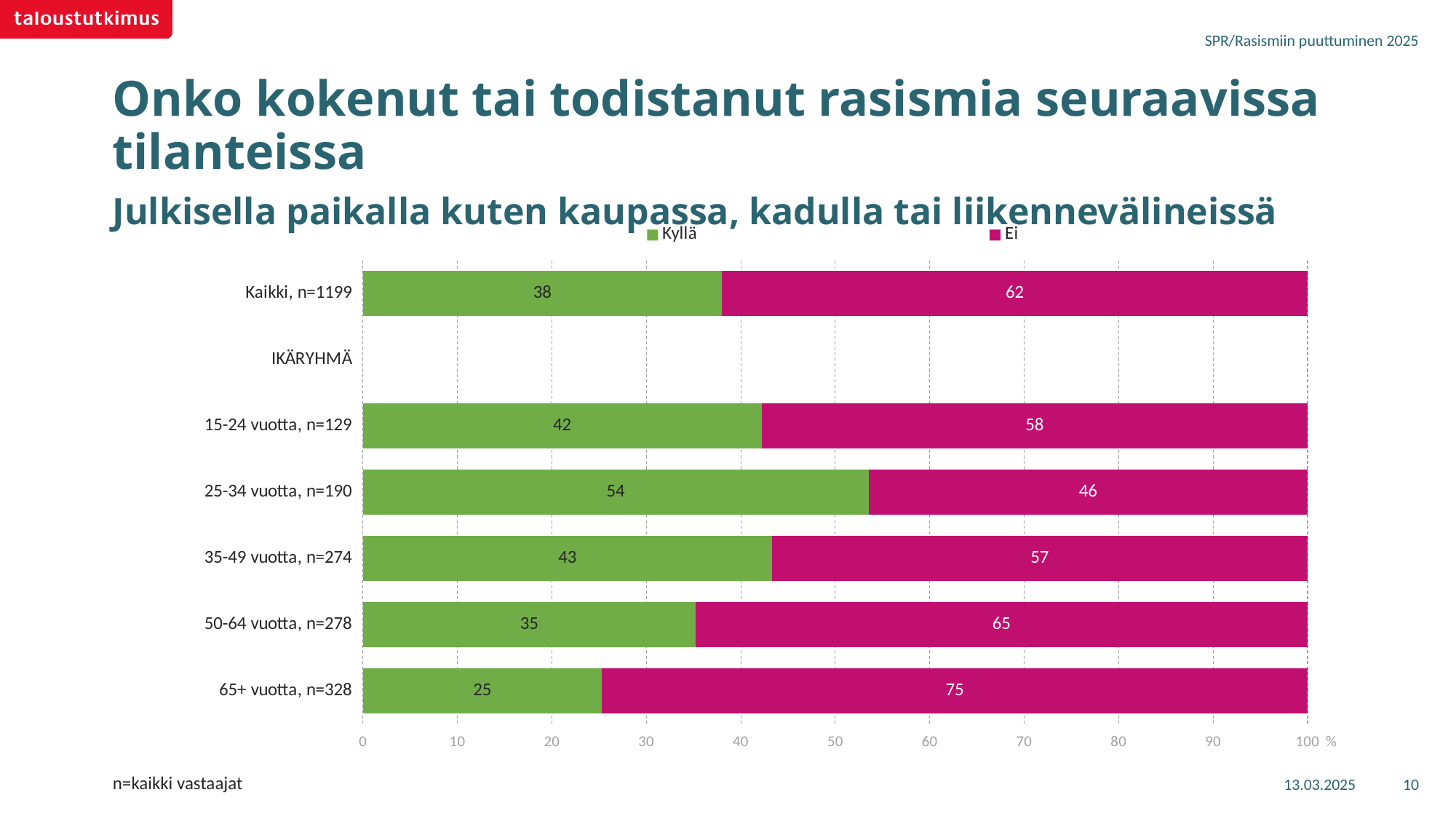
What is the difference between the Ei values for 65+ vuotta, n=328 and 25-34 vuotta, n=190? 29 How many series does the legend list? 2 What is the total of the stacked bar for 35-49 vuotta, n=274? 100 Which is larger, the Kyllä value for 15-24 vuotta, n=129 or for 35-49 vuotta, n=274? 35-49 vuotta, n=274 Which age group has the lowest Kyllä value? 65+ vuotta, n=328 What is the Ei value for 65+ vuotta, n=328? 75 Is the Ei value for 50-64 vuotta, n=278 greater or less than 60? greater What kind of chart is shown on the slide? Stacked bar chart What is the Kyllä value for Kaikki, n=1199? 38 Which colour represents the Ei series in the chart? Magenta/pink What is the Kyllä value for 25-34 vuotta, n=190? 54 Which age group has the highest Kyllä value? 25-34 vuotta, n=190